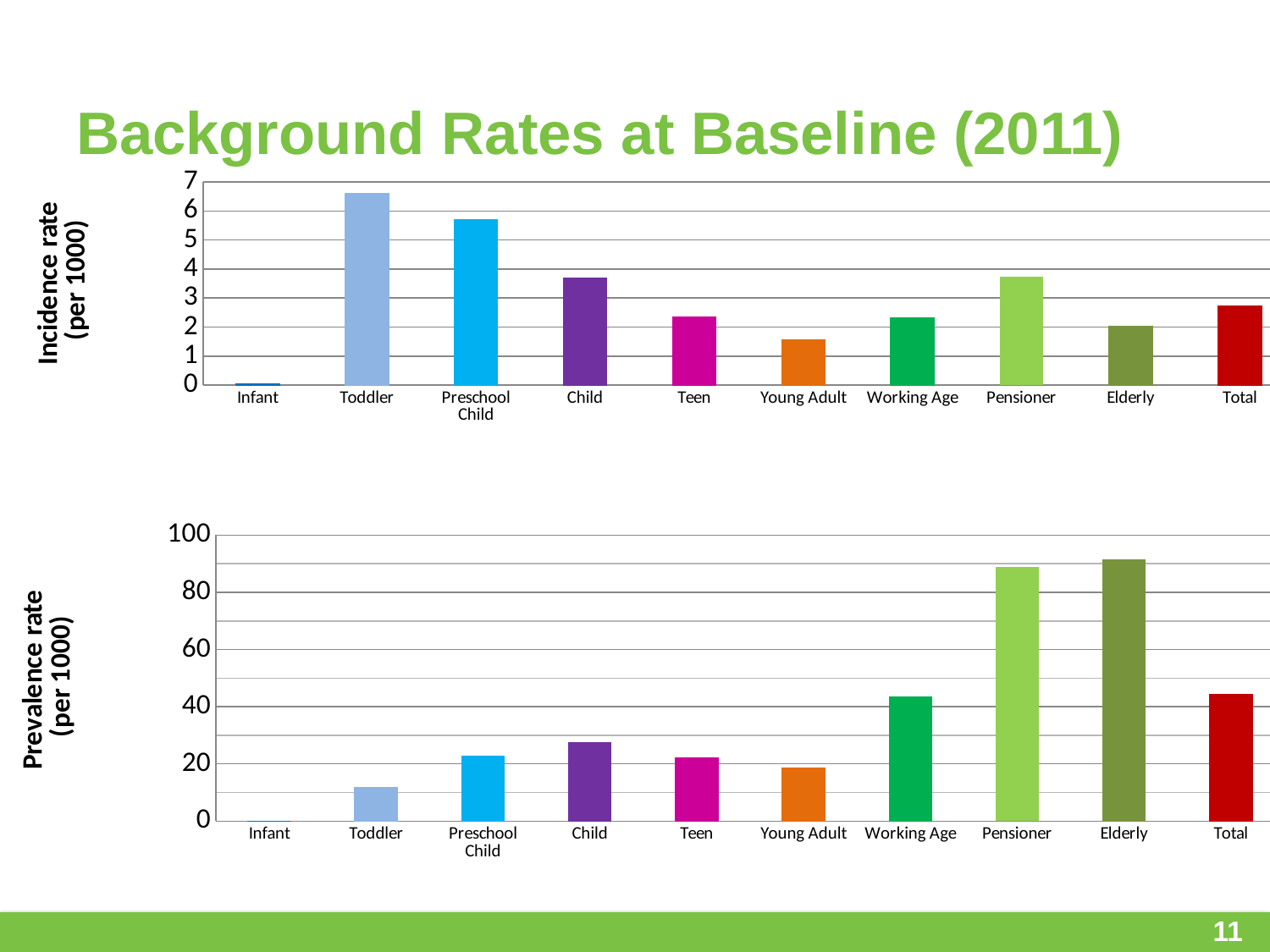
In the top chart (Incidence rate per 1000), which category has the lowest value? Infant In the bottom chart (Prevalence rate per 1000), which category has the lowest value? Infant In the top chart (Incidence rate per 1000), which category has the highest value? Toddler What kind of chart is the top chart (Incidence rate per 1000)? Bar chart In the bottom chart (Prevalence rate per 1000), is the value for Toddler greater or less than 20? less In the bottom chart (Prevalence rate per 1000), which is larger, the value for Working Age or the value for Child? Working Age In the top chart (Incidence rate per 1000), is the value for Toddler greater or less than 6? greater In the top chart (Incidence rate per 1000), which is larger, the value for Toddler or the value for Preschool Child? Toddler How many categories are shown on the x axis of the top chart (Incidence rate per 1000)? 10 What is the y-axis title of the bottom chart? Prevalence rate (per 1000) In the top chart (Incidence rate per 1000), is the value for Preschool Child greater or less than 5? greater